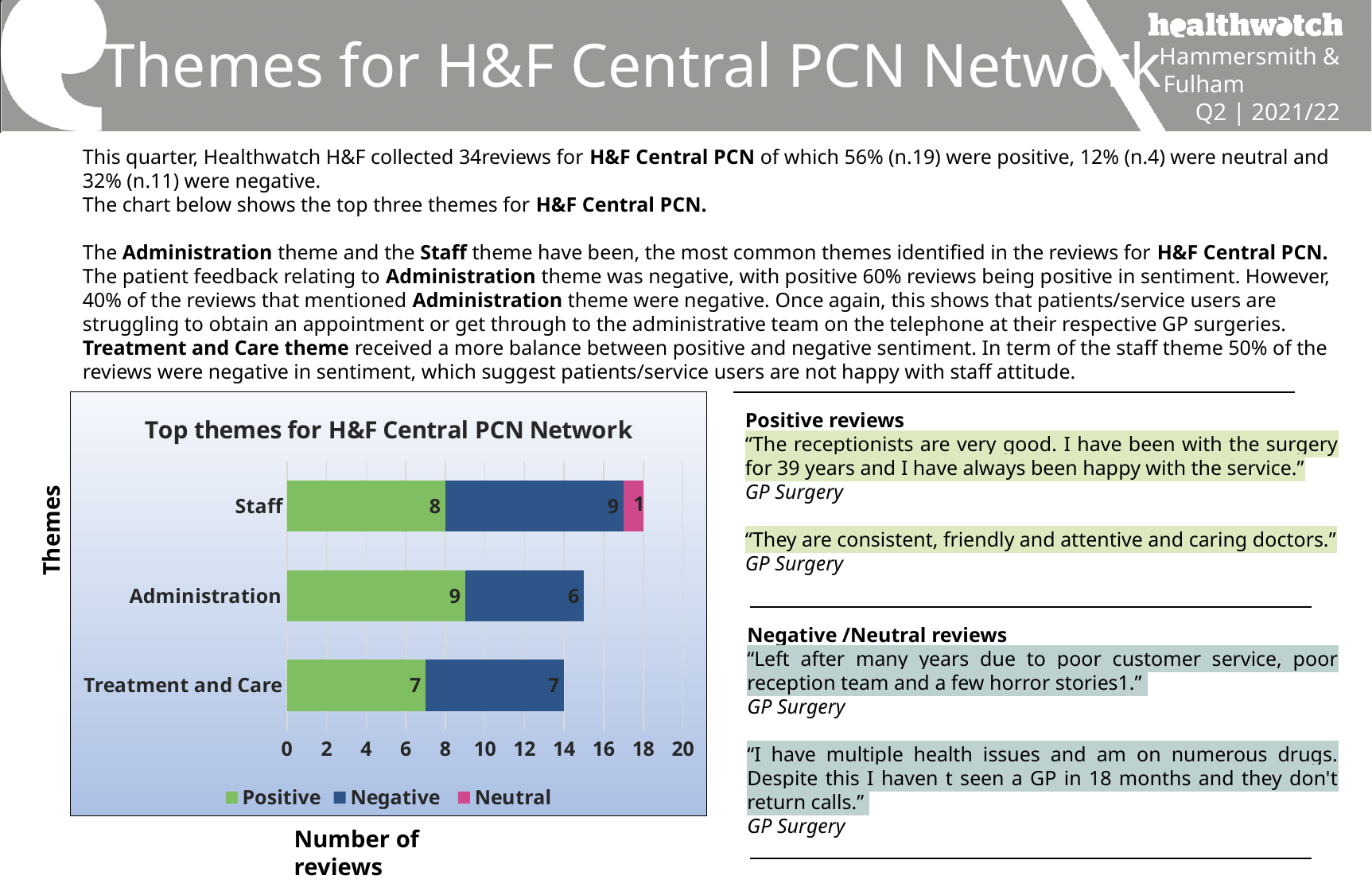
How many neutral reviews are shown for the Staff theme? 1 What is the total number of reviews in the Administration bar? 15 What is the total number of reviews in the Staff bar? 18 Which theme has the highest total number of reviews? Staff How many series does the chart legend list? 3 How many negative reviews are shown for the Administration theme? 6 What kind of chart is shown on the slide? Stacked bar chart How many themes are plotted on the chart? 3 How many positive reviews are shown for the Staff theme? 8 What is the difference between the positive and negative reviews for the Administration theme? 3 Which is larger: the number of positive reviews for Administration or the number of positive reviews for Treatment and Care? Administration What is the title of the chart? Top themes for H&F Central PCN Network